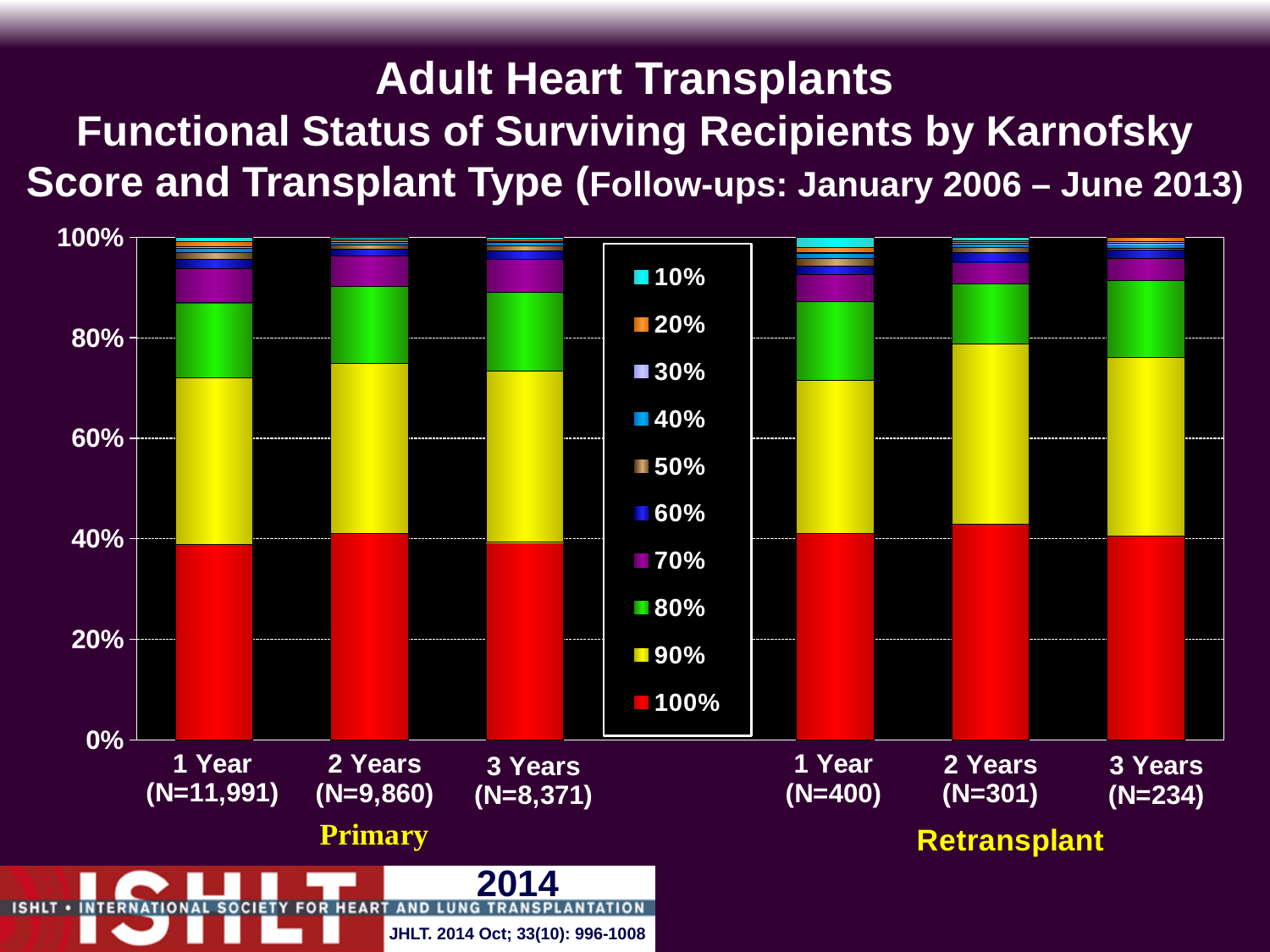
How many follow-up time points are shown for the Primary transplant group? 3 Which bar has the larger 100% Karnofsky score segment: Primary 1 Year or Retransplant 2 Years? Retransplant 2 Years What is the sample size (N) shown for the Retransplant 3 Years bar? N=234 What is the sample size (N) shown for the Primary 1 Year bar? N=11,991 Is the 100% Karnofsky score segment for the Retransplant 2 Years bar greater or less than 40%? greater Is the combined share of the 90% and 100% Karnofsky score segments for the Primary 1 Year bar greater or less than 80%? less How many bars are plotted in the chart? 6 Which colour represents the 100% Karnofsky score in the legend? Red What kind of chart is shown on the slide? Stacked bar chart What is the total of the stacked bar for Primary 3 Years? 100% Is the combined share of the 90% and 100% Karnofsky score segments for the Retransplant 1 Year bar greater or less than 60%? greater How many series does the legend list? 10